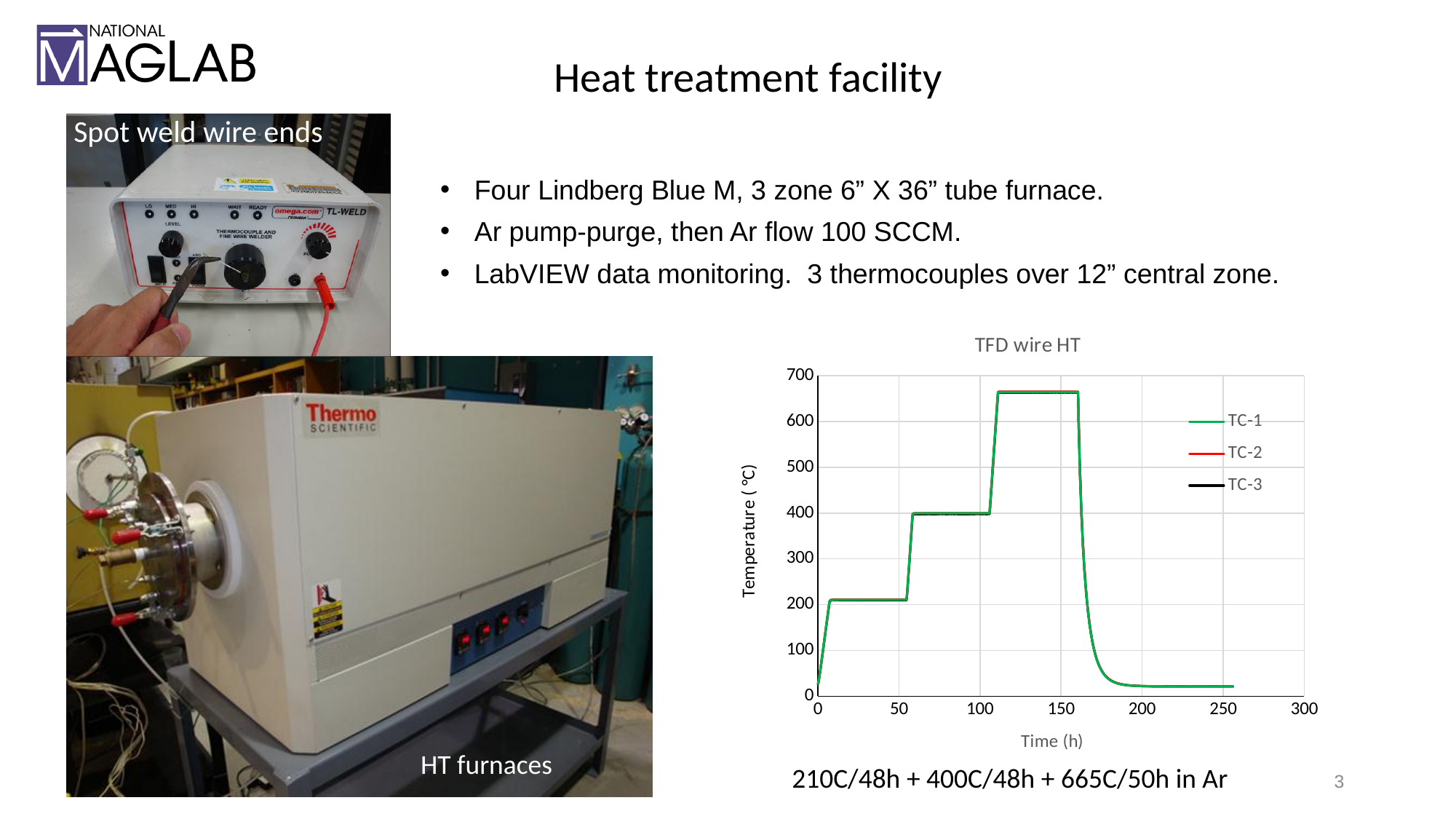
In the TFD wire HT chart, is the temperature at 150 h greater or less than 600? greater What kind of chart is shown on the slide? line chart How many series does the legend of the TFD wire HT chart list? 3 How many temperature plateaus (holds) are visible in the TFD wire HT chart before the cool-down? 3 In the TFD wire HT chart, is the temperature at 250 h greater or less than 100? less In the TFD wire HT chart, does the temperature rise or fall between 160 h and 200 h? fall In the TFD wire HT chart, does the temperature generally rise or fall between 0 h and 150 h? rise In the TFD wire HT chart, is the temperature at 150 h higher or lower than at 100 h? higher In the TFD wire HT chart, is the temperature at 25 h greater or less than 300? less What is the title of the chart on the slide? TFD wire HT What is the label of the x axis of the chart? Time (h)